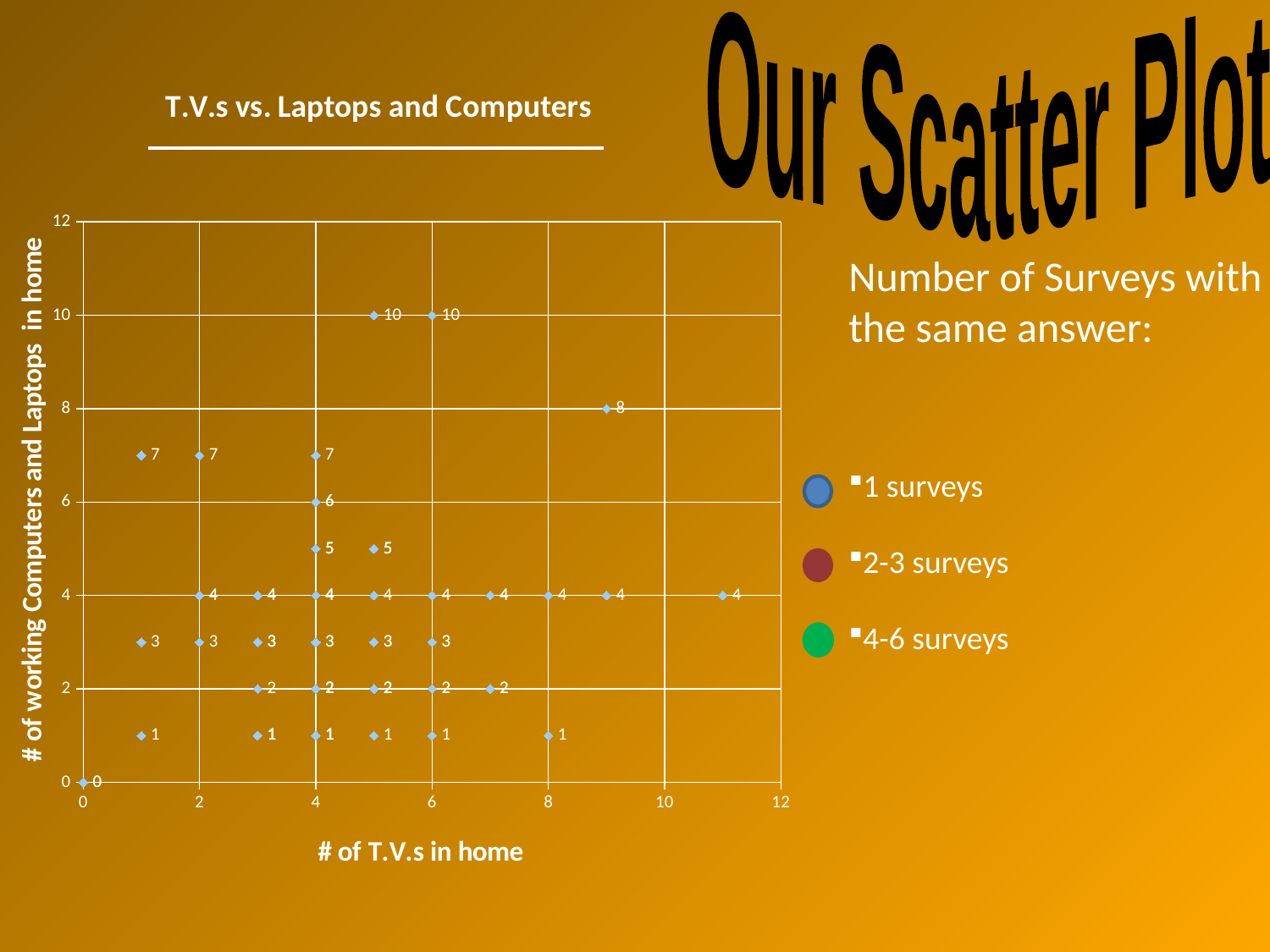
How many points on the chart have a value of 4 working computers and laptops? 9 How many points on the chart have a value of 10 working computers and laptops? 2 What is the number of working computers and laptops for the point at 11 T.V.s in home? 4 What is the number of working computers and laptops for the point at 9 T.V.s that is above 6 on the y axis? 8 What kind of chart is shown on the slide? scatter plot What is the difference between the highest y value (10) and the y value of the point at 11 T.V.s (4)? 6 Is the highest point on the chart greater or less than 8 on the y axis? greater How many points on the chart have a value of 7 working computers and laptops? 3 What is the highest number of working computers and laptops plotted on the chart? 10 What is the label of the x axis of the chart? # of T.V.s in home What is the title of the chart? T.V.s vs. Laptops and Computers